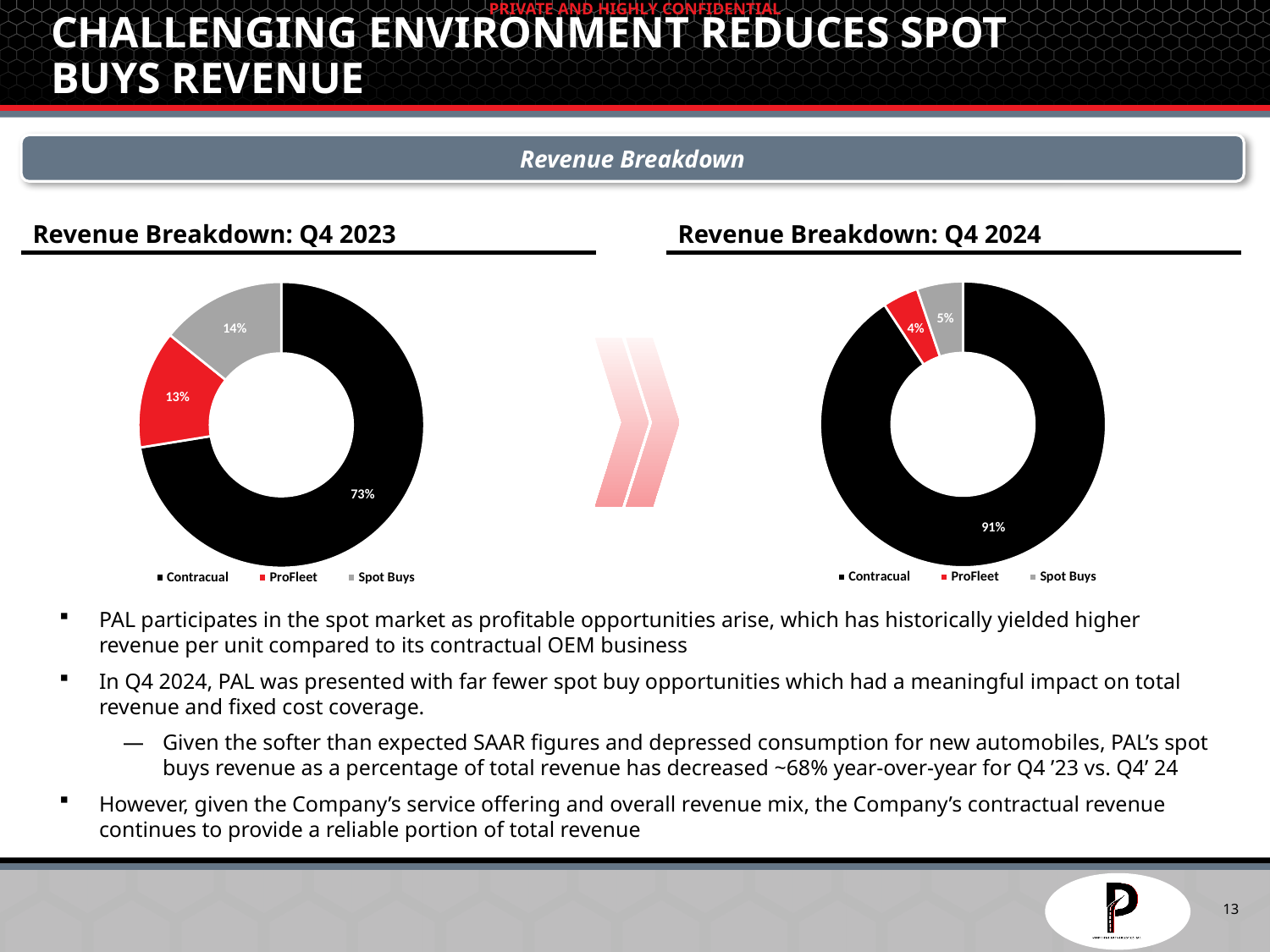
In the Revenue Breakdown: Q4 2023 chart, what is the difference between the Spot Buys share and the ProFleet share? 1 percentage point In the Revenue Breakdown: Q4 2024 chart, which category has the largest share? Contracual In the Revenue Breakdown: Q4 2023 chart, what share of revenue is Contracual? 73% In the Revenue Breakdown: Q4 2024 chart, what share of revenue is ProFleet? 4% In the Revenue Breakdown: Q4 2023 chart, which category has the smallest share? ProFleet In the Revenue Breakdown: Q4 2023 chart, what colour represents ProFleet? Red How many categories does the Revenue Breakdown: Q4 2024 chart show? 3 In the Revenue Breakdown: Q4 2023 chart, what share of revenue is Spot Buys? 14% What is the difference between the Contracual share in the Q4 2024 chart and the Contracual share in the Q4 2023 chart? 18 percentage points Is the Spot Buys share larger in the Q4 2023 chart or the Q4 2024 chart? Q4 2023 In the Revenue Breakdown: Q4 2024 chart, what share of revenue is Spot Buys? 5% What type of chart is the Revenue Breakdown: Q4 2023 chart? Donut (pie) chart